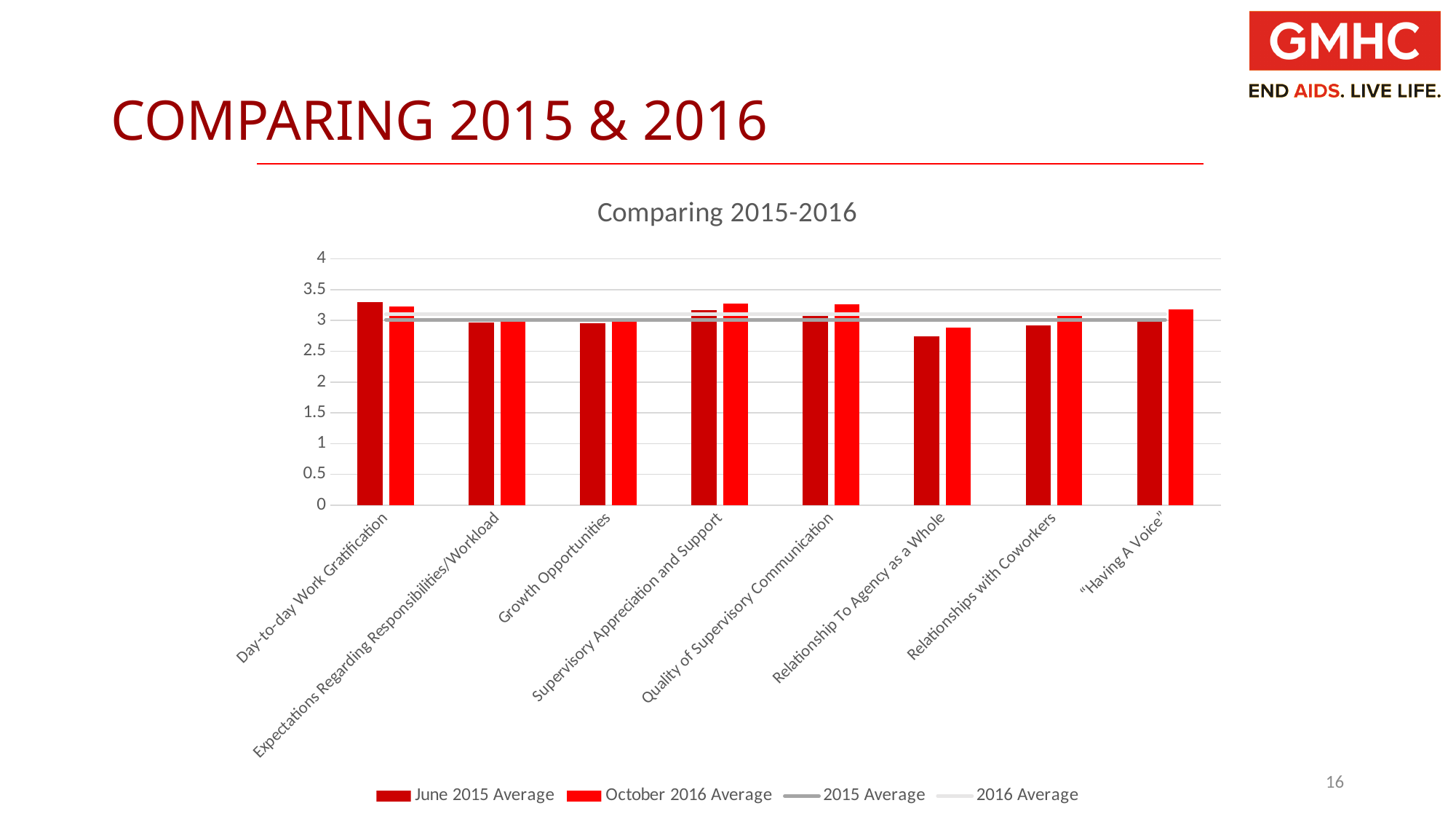
For Day-to-day Work Gratification, which is larger: the June 2015 Average or the October 2016 Average? June 2015 Average How many entries does the chart legend list? 4 Which category has the lowest October 2016 Average? Relationship To Agency as a Whole Is the October 2016 Average for "Having A Voice" greater or less than 3? greater What is the title of the chart? Comparing 2015-2016 Which category has the highest June 2015 Average? Day-to-day Work Gratification How many categories are shown along the x axis of the chart? 8 For Quality of Supervisory Communication, which is larger: the June 2015 Average or the October 2016 Average? October 2016 Average Which category has the lowest June 2015 Average? Relationship To Agency as a Whole What kind of chart is shown on the slide? Bar and line chart Which legend entry is shown as a dark red bar? June 2015 Average Is the June 2015 Average for Relationship To Agency as a Whole greater or less than 3? less